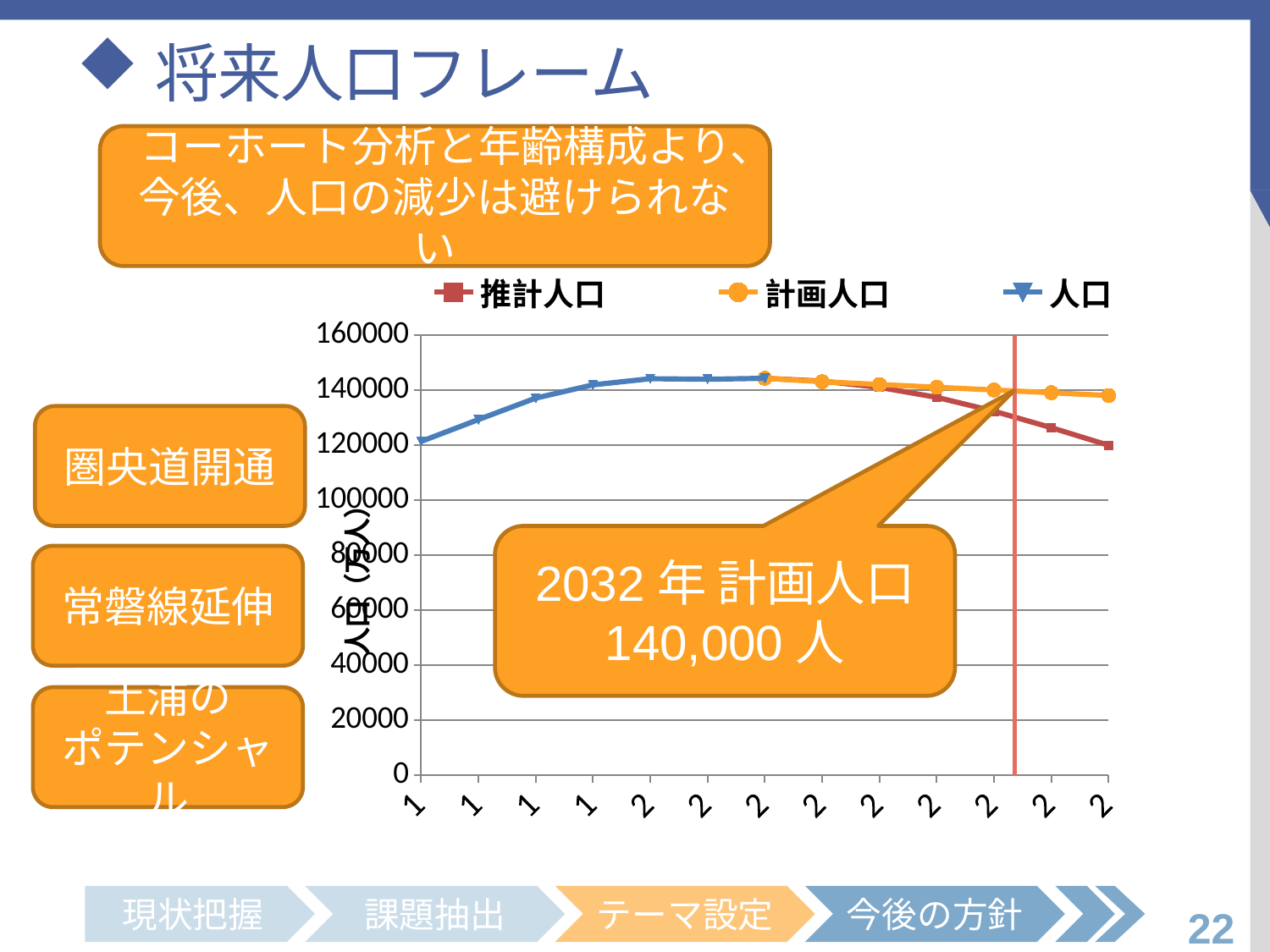
At the right end of the chart, which series is higher: 計画人口 or 推計人口? 計画人口 What are the three series named in the chart legend? 推計人口, 計画人口, 人口 Is the final value of the 推計人口 series greater or less than 140000? less Does the 推計人口 (red) series rise or fall along the x axis? fall What is the maximum value shown on the chart's vertical axis? 160000 Which series is drawn in orange on the chart? 計画人口 Is the highest value of the 人口 (blue) series greater or less than 140000? greater How many series does the chart legend list? 3 What kind of chart is shown on the slide? line chart How many tick labels are shown along the chart's x axis? 13 Does the 人口 (blue) series rise or fall along the x axis? rise According to the callout on the chart, what is the planned population (計画人口) for 2032? 140,000 人